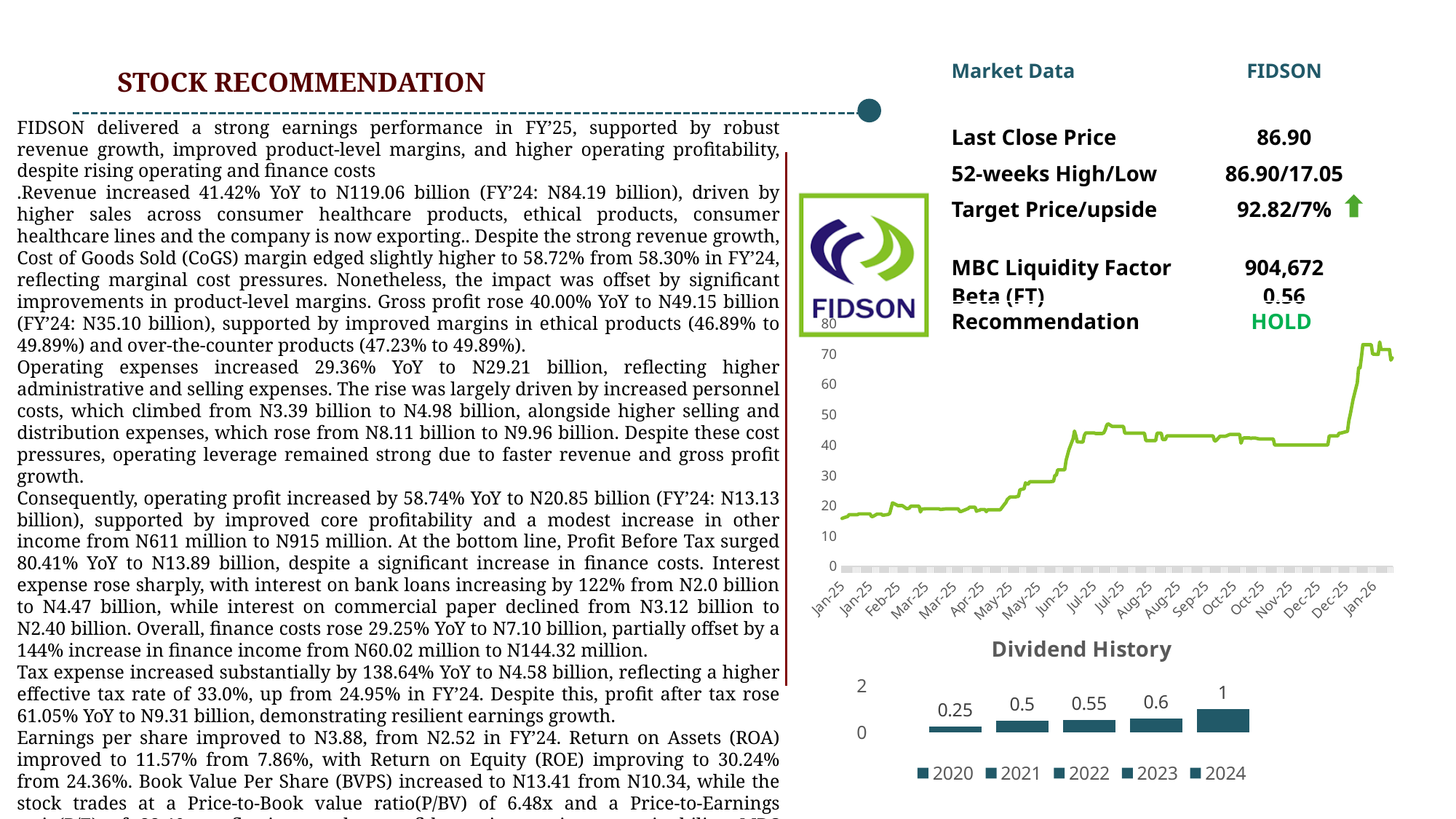
How many years are shown in the Dividend History chart? 5 In the Dividend History chart, which year has the highest dividend? 2024 In the line chart above the Dividend History chart, is the value at Jan-26 greater or less than 60? greater In the Dividend History chart, what is the dividend value for 2022? 0.55 In the Dividend History chart, what is the dividend value for 2020? 0.25 Do the dividend values in the Dividend History chart rise or fall from 2020 to 2024? rise What kind of chart is the price chart above the Dividend History chart? line chart In the Dividend History chart, which is larger, the dividend for 2021 or for 2023? 2023 How many entries does the legend of the Dividend History chart list? 5 In the Dividend History chart, which year has the lowest dividend? 2020 In the Dividend History chart, what is the dividend value for 2024? 1 In the Dividend History chart, what is the difference between the 2024 and 2020 dividend values? 0.75